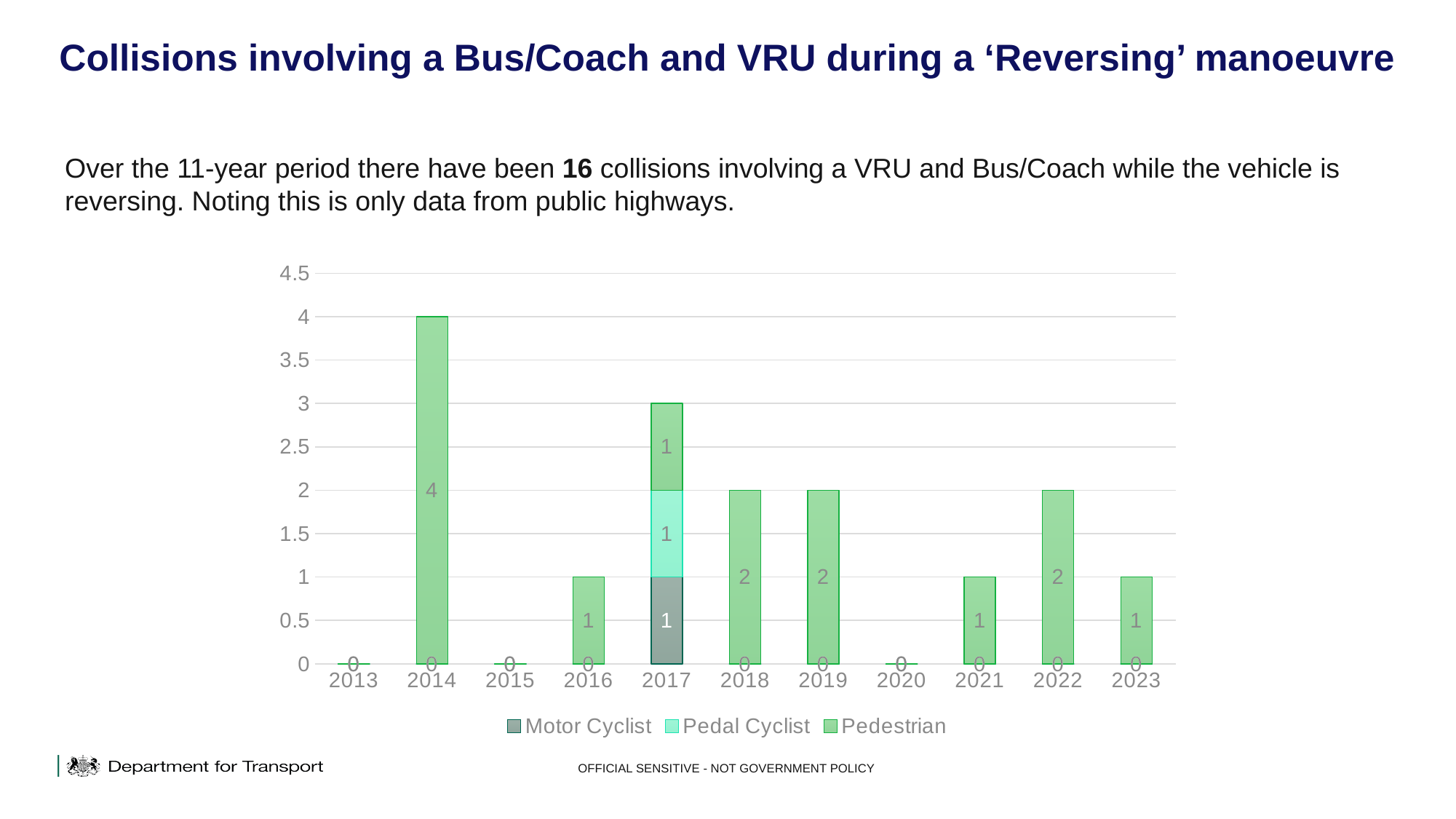
How many series does the legend list? 3 What is the Pedal Cyclist value for 2017? 1 What is the Motor Cyclist value for 2017? 1 What is the total height of the stacked bar for 2017? 3 Which year has the highest total number of collisions? 2014 Which is larger, the Pedestrian value for 2022 or for 2023? 2022 How many years are shown on the x axis? 11 What is the Pedestrian value for 2019? 2 What is the Pedestrian value for 2014? 4 What is the difference between the Pedestrian values for 2014 and 2018? 2 Which series is shown in the darkest colour in the legend? Motor Cyclist What type of chart is shown on the slide? Stacked bar chart